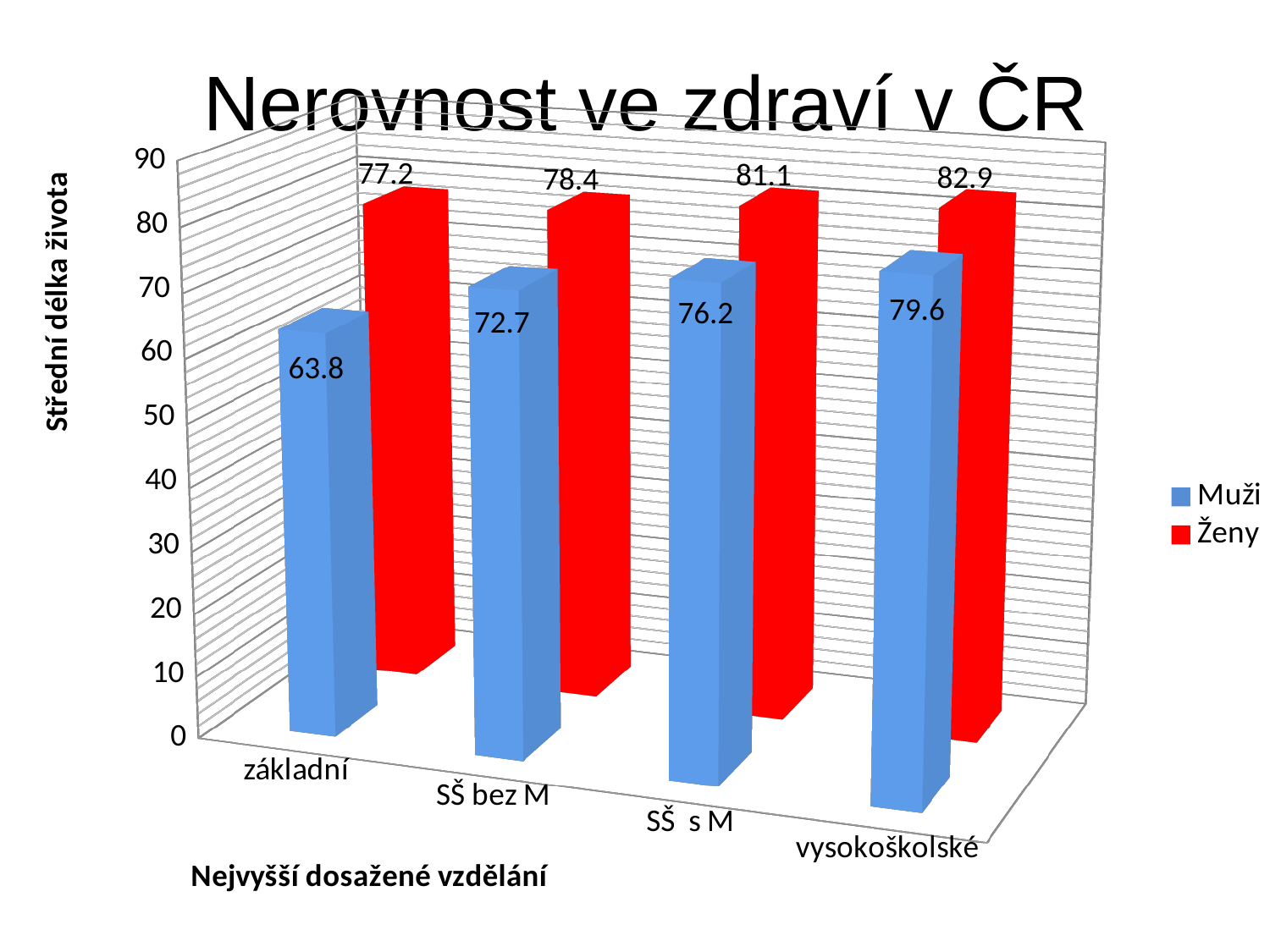
What kind of chart is shown on the slide? bar chart Which is larger in the vysokoškolské category, Muži or Ženy? Ženy What is the value for Ženy in the vysokoškolské category? 82.9 How many categories are shown on the x axis? 4 Do the Muži values rise or fall from základní to vysokoškolské? rise How many series does the legend list? 2 Which category has the lowest value for Ženy? základní What is the value for Muži in the SŠ s M category? 76.2 What is the difference between the Ženy and Muži values in the základní category? 13.4 What is the value for Ženy in the SŠ bez M category? 78.4 What is the value for Muži in the základní category? 63.8 Which category has the highest value for Muži? vysokoškolské